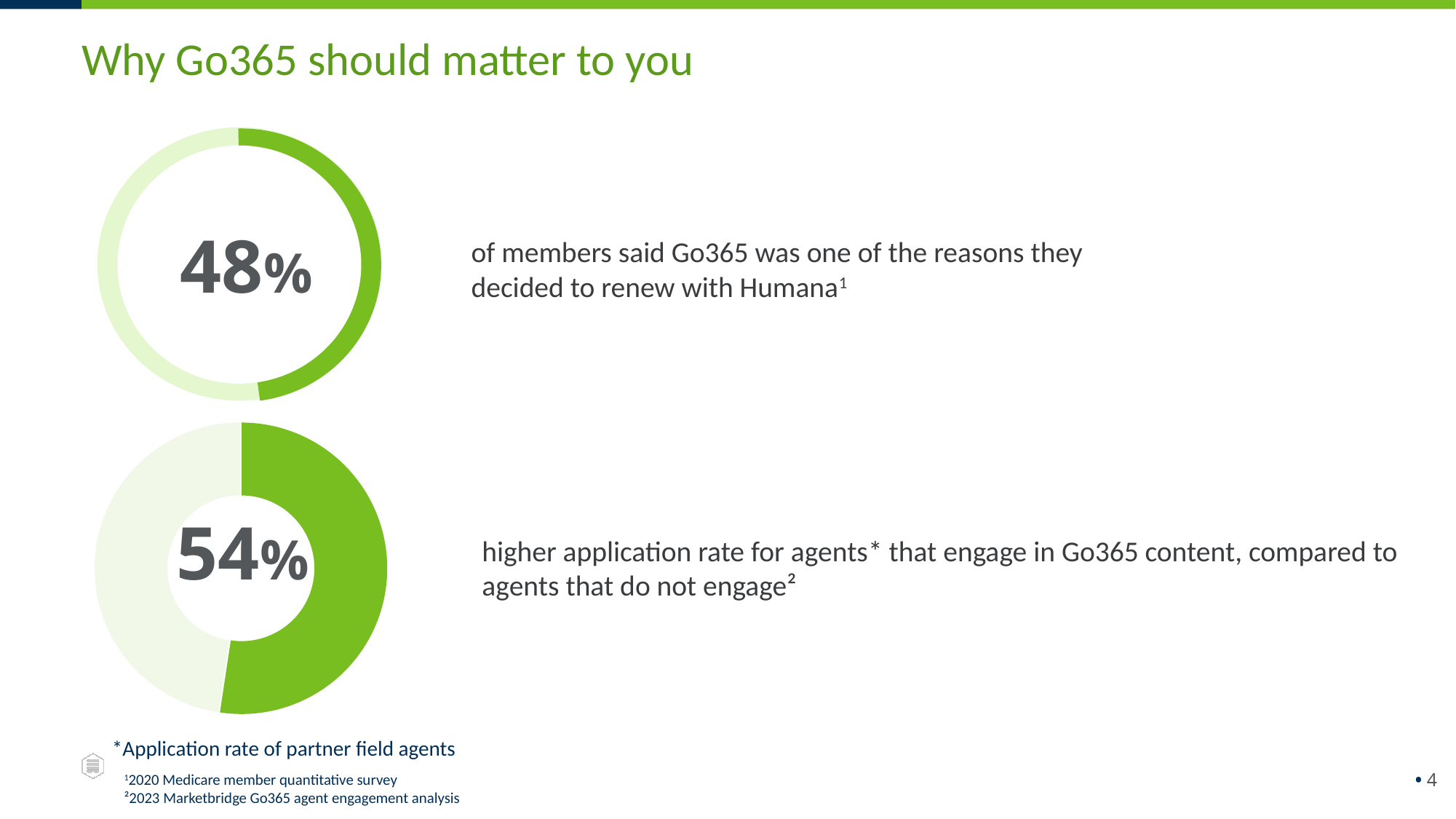
Is the value shown in the top donut chart greater or less than 50%? less What percentage is shown in the centre of the bottom donut chart? 54% What share of the top donut chart is filled with the dark green segment? 48% According to the text next to the top donut chart, what does the 48% figure represent? Members who said Go365 was one of the reasons they decided to renew with Humana What percentage is shown in the centre of the top donut chart? 48% Which of the two donut charts shows the larger percentage, the top one or the bottom one? The bottom one (54%) What kind of chart is used to show the 48% figure at the top of the slide? Donut (pie) chart What share of the bottom donut chart is filled with the dark green segment? 54% Is the value shown in the bottom donut chart greater or less than 50%? greater What is the difference in percentage points between the bottom donut chart's value (54%) and the top donut chart's value (48%)? 6 percentage points What colour is used for the filled segment in both donut charts? Green How many donut charts are on the slide? 2